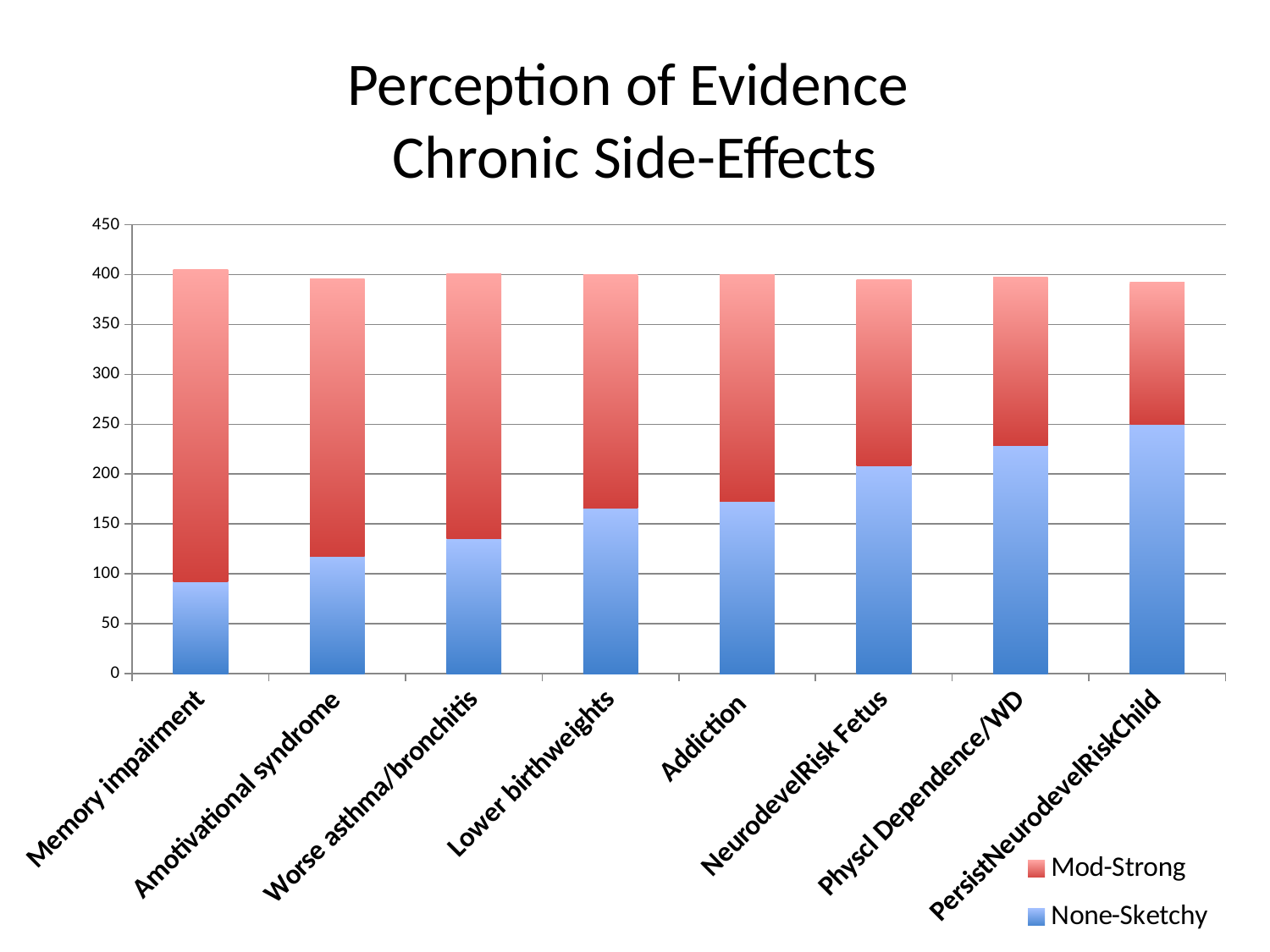
Is the None-Sketchy value for Memory impairment greater or less than 100? less How many series does the legend list? 2 Which category has the largest Mod-Strong segment? Memory impairment How many categories are shown on the x axis? 8 What kind of chart is shown on the slide? Stacked bar chart Which has the larger None-Sketchy value, Memory impairment or Addiction? Addiction What are the two series named in the legend? Mod-Strong and None-Sketchy Which category has the lowest None-Sketchy value? Memory impairment Which category has the highest None-Sketchy value? PersistNeurodevelRiskChild Is the None-Sketchy value for Addiction greater or less than 150? greater Is the None-Sketchy value for Physcl Dependence/WD greater or less than 200? greater Do the None-Sketchy values rise or fall moving from left to right along the x axis? rise